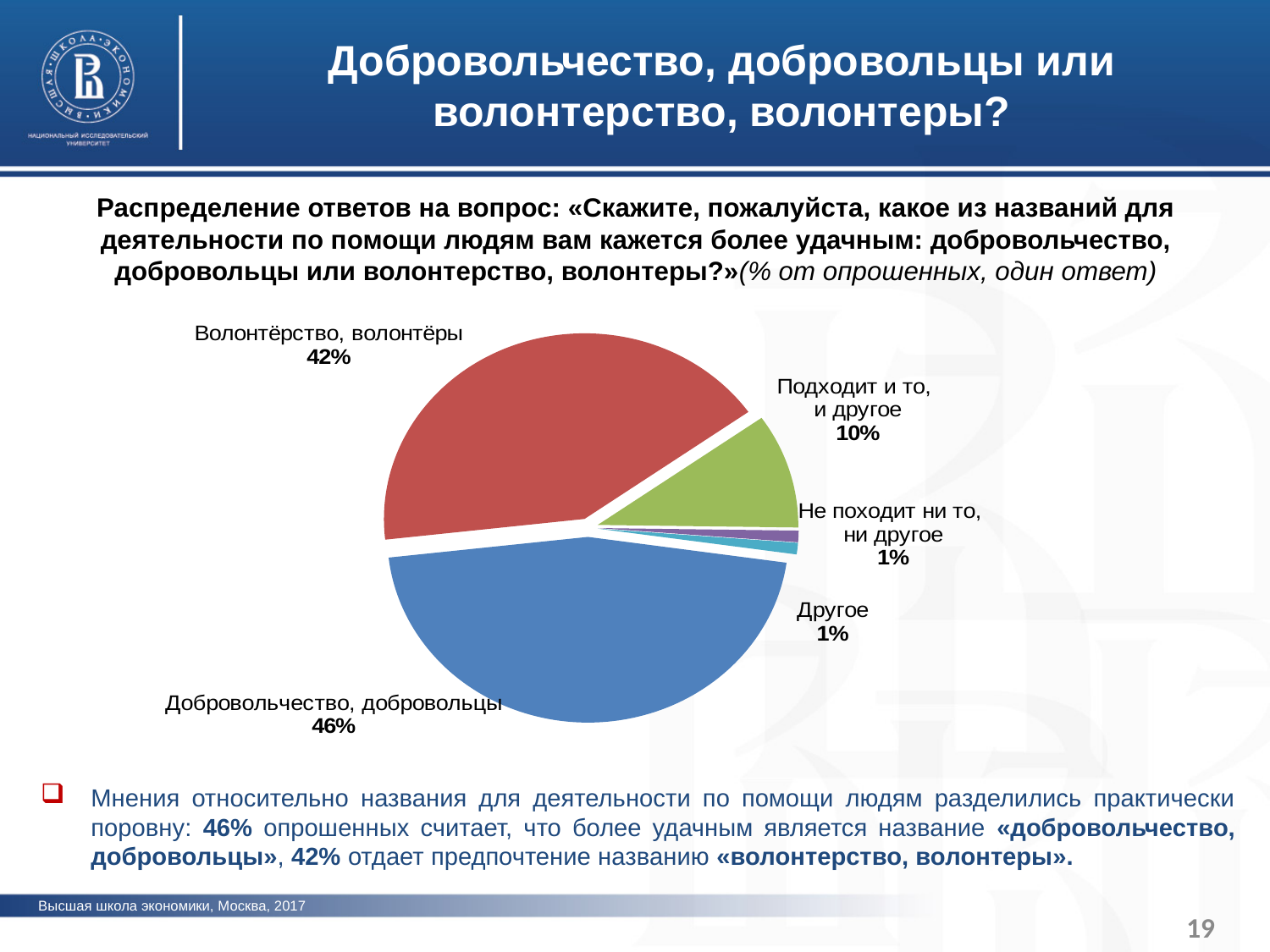
What share of respondents chose «Волонтёрство, волонтёры»? 42% What colour is the slice for «Добровольчество, добровольцы»? Blue Which is larger: the share for «Волонтёрство, волонтёры» or for «Подходит и то, и другое»? Волонтёрство, волонтёры What is the difference between the shares for «Волонтёрство, волонтёры» and «Подходит и то, и другое»? 32 percentage points What colour is the slice for «Подходит и то, и другое»? Green What type of chart is shown on the slide? Pie chart Which answer option has the largest share of the pie? Добровольчество, добровольцы What percentage of respondents answered «Не походит ни то, ни другое»? 1% By how many percentage points does «Добровольчество, добровольцы» exceed «Волонтёрство, волонтёры»? 4 percentage points What percentage of respondents answered «Другое»? 1% What percentage of respondents answered «Подходит и то, и другое»? 10% What share of respondents chose «Добровольчество, добровольцы»? 46%